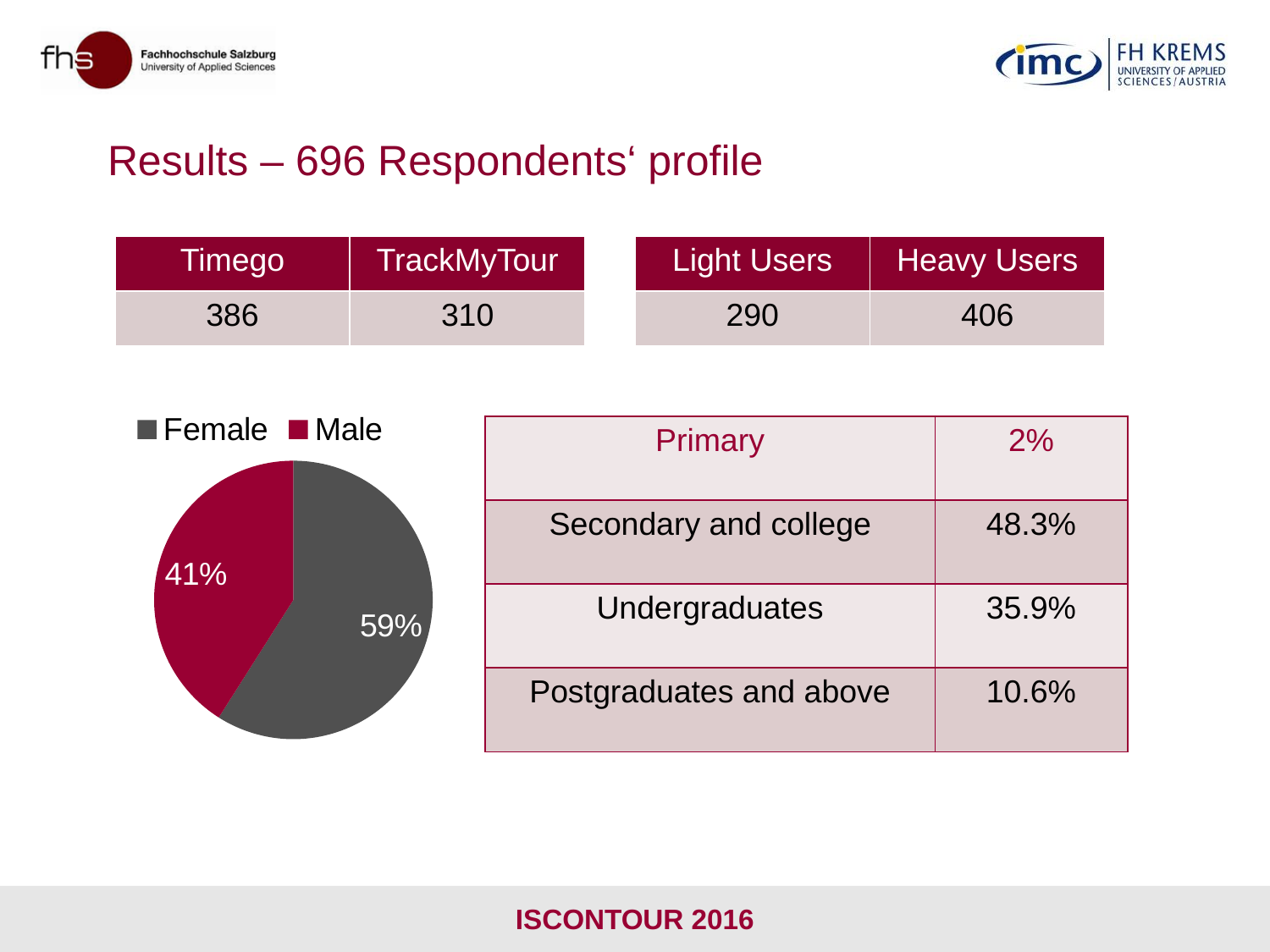
Which slice of the pie chart is the largest? Female What kind of chart is shown on the slide? pie chart Which is larger in the pie chart, the Female slice or the Male slice? Female What is the difference in percentage points between the Female and Male slices of the pie chart? 18 How many slices does the pie chart have? 2 What share of the pie chart is Female? 59% What share of the pie chart is Male? 41% How many entries does the pie chart's legend list? 2 Which slice of the pie chart is the smallest? Male Is the Male share in the pie chart greater or less than 50%? less What colour is the Female slice in the pie chart? dark grey What colour is the Male slice in the pie chart? dark red